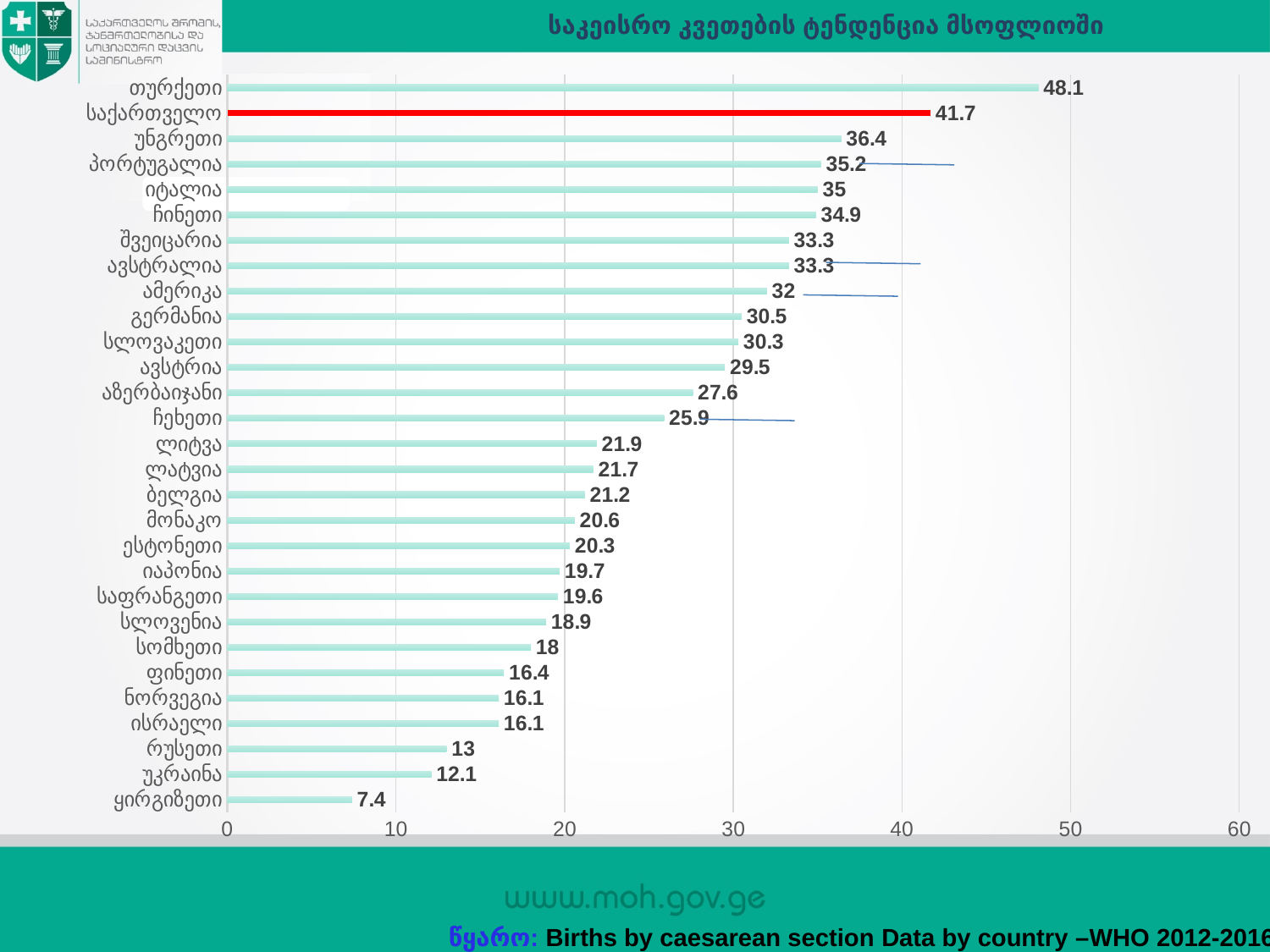
What is the value for თურქეთი? 48.1 What is the value for აზერბაიჯანი? 27.6 Which country has the lowest value? ყირგიზეთი Which country has the highest value? თურქეთი What kind of chart is shown on the slide? bar chart Which has a larger value, უნგრეთი or გერმანია? უნგრეთი How many countries are shown in the chart? 29 Is the value for ჩეხეთი greater or less than 30? less What is the value for საქართველო? 41.7 Which bar is highlighted in red? საქართველო What is the value for ყირგიზეთი? 7.4 What is the difference between the values for თურქეთი and საქართველო? 6.4